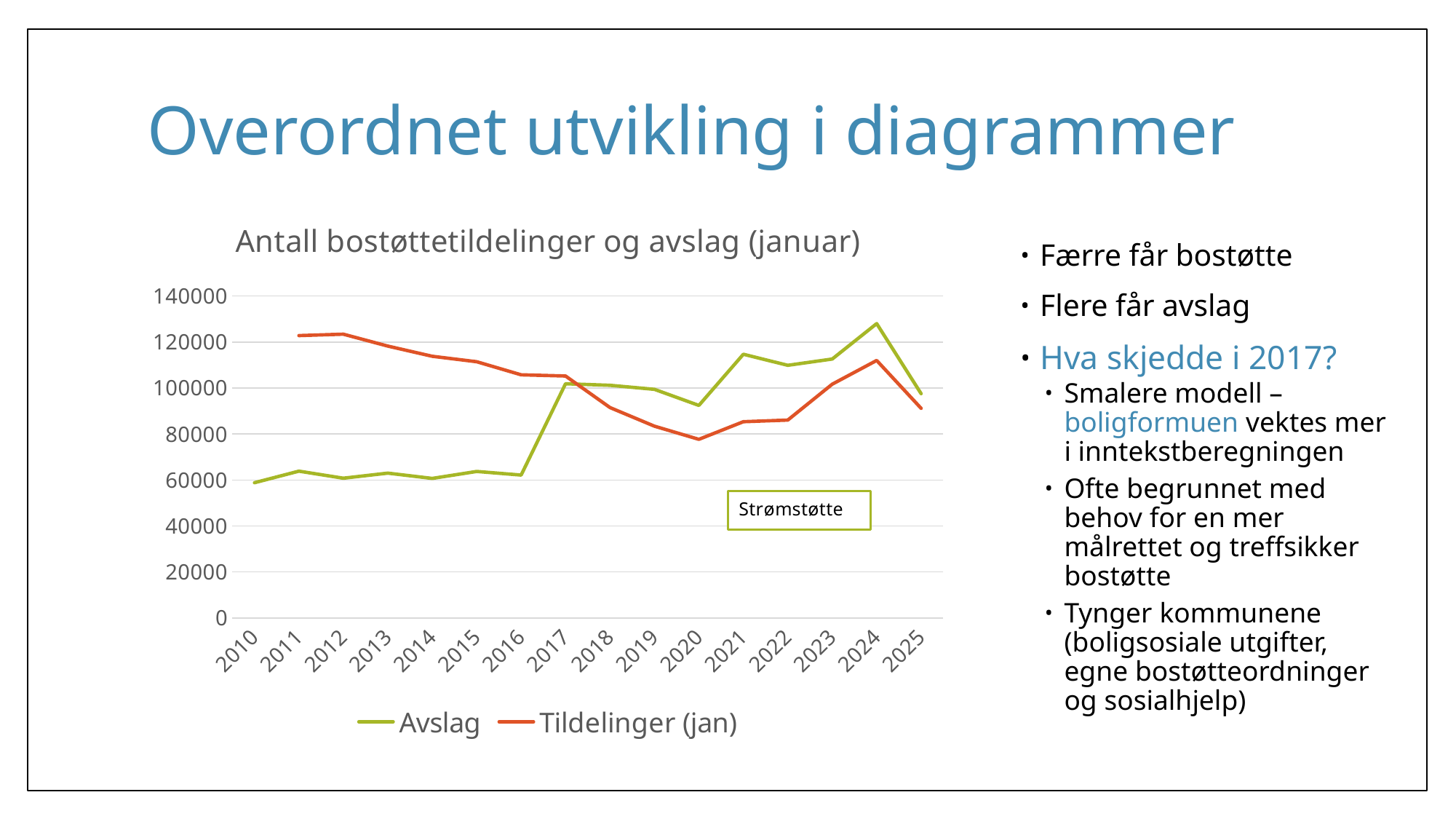
Which series has the larger value in 2016, Avslag or Tildelinger (jan)? Tildelinger (jan) How many years are shown on the x axis? 16 What is the title of the chart? Antall bostøttetildelinger og avslag (januar) Is the value for Avslag in 2024 greater or less than 120000? greater In which year does the Tildelinger (jan) series reach its lowest value? 2020 Which series has the larger value in 2021, Avslag or Tildelinger (jan)? Avslag Is the value for Tildelinger (jan) in 2025 greater or less than 100000? less Does the Tildelinger (jan) series rise or fall from 2012 to 2020? fall What kind of chart is shown on the slide? line chart How many series does the legend list? 2 In which year does the Avslag series reach its highest value? 2024 Is the value for Tildelinger (jan) in 2011 greater or less than 120000? greater